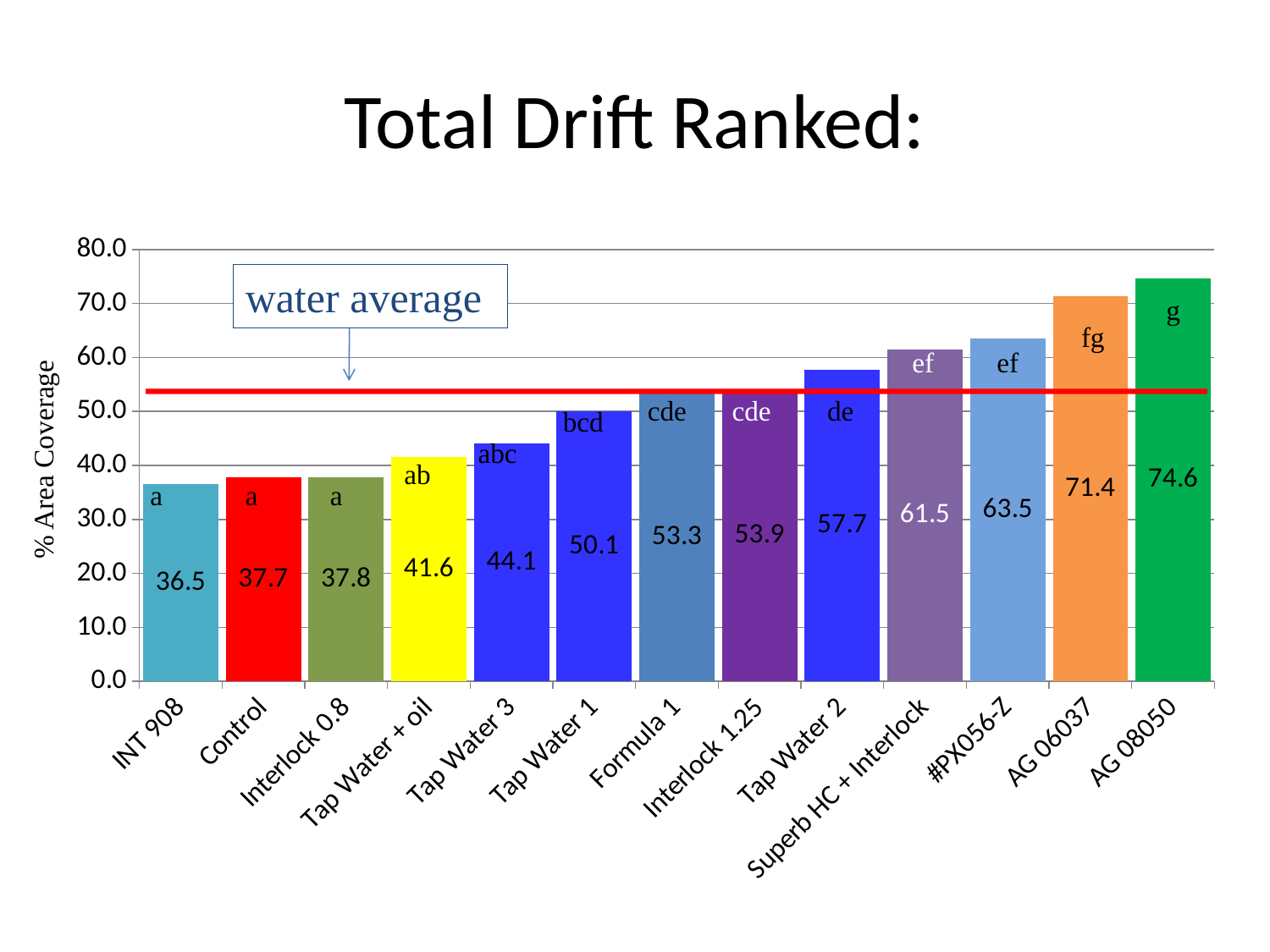
What is the difference in % Area Coverage between Tap Water 2 and Tap Water 3? 13.6 Which has a higher % Area Coverage, Formula 1 or Tap Water + oil? Formula 1 What is the difference in % Area Coverage between AG 08050 and INT 908? 38.1 What is the % Area Coverage value for AG 06037? 71.4 What does the red horizontal line on the chart represent? water average Which category has the lowest % Area Coverage? INT 908 What is the % Area Coverage value for Tap Water 1? 50.1 Which category has the highest % Area Coverage? AG 08050 How many categories are shown on the x axis? 13 What is the % Area Coverage value for Control? 37.7 What kind of chart is shown on the slide? bar chart Is the value for #PX056-Z greater or less than 60.0? greater